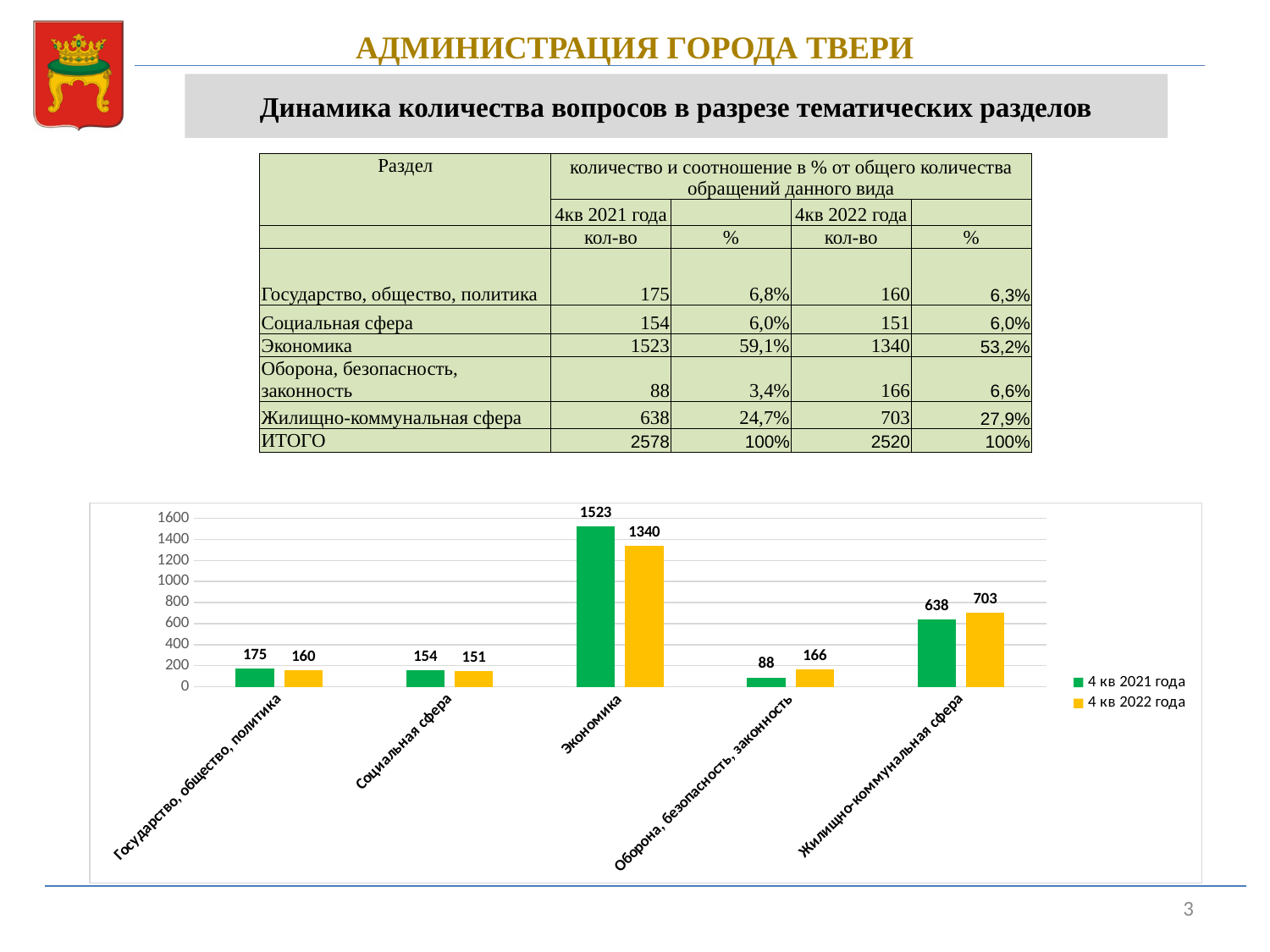
What is the value for Экономика in the 4 кв 2021 года series? 1523 How many categories are shown on the x axis of the chart? 5 Which category has the lowest value in the 4 кв 2021 года series? Оборона, безопасность, законность Is the value for Жилищно-коммунальная сфера in the 4 кв 2021 года series greater or less than 600? greater What kind of chart is shown on the slide? bar chart Which is larger for Оборона, безопасность, законность: the 4 кв 2021 года value or the 4 кв 2022 года value? 4 кв 2022 года What colour are the bars for the 4 кв 2022 года series? yellow How many series does the chart legend list? 2 What is the difference between the 4 кв 2021 года and 4 кв 2022 года values for Экономика? 183 What is the value for Жилищно-коммунальная сфера in the 4 кв 2022 года series? 703 Which category has the highest value in the 4 кв 2022 года series? Экономика What is the value for Оборона, безопасность, законность in the 4 кв 2021 года series? 88